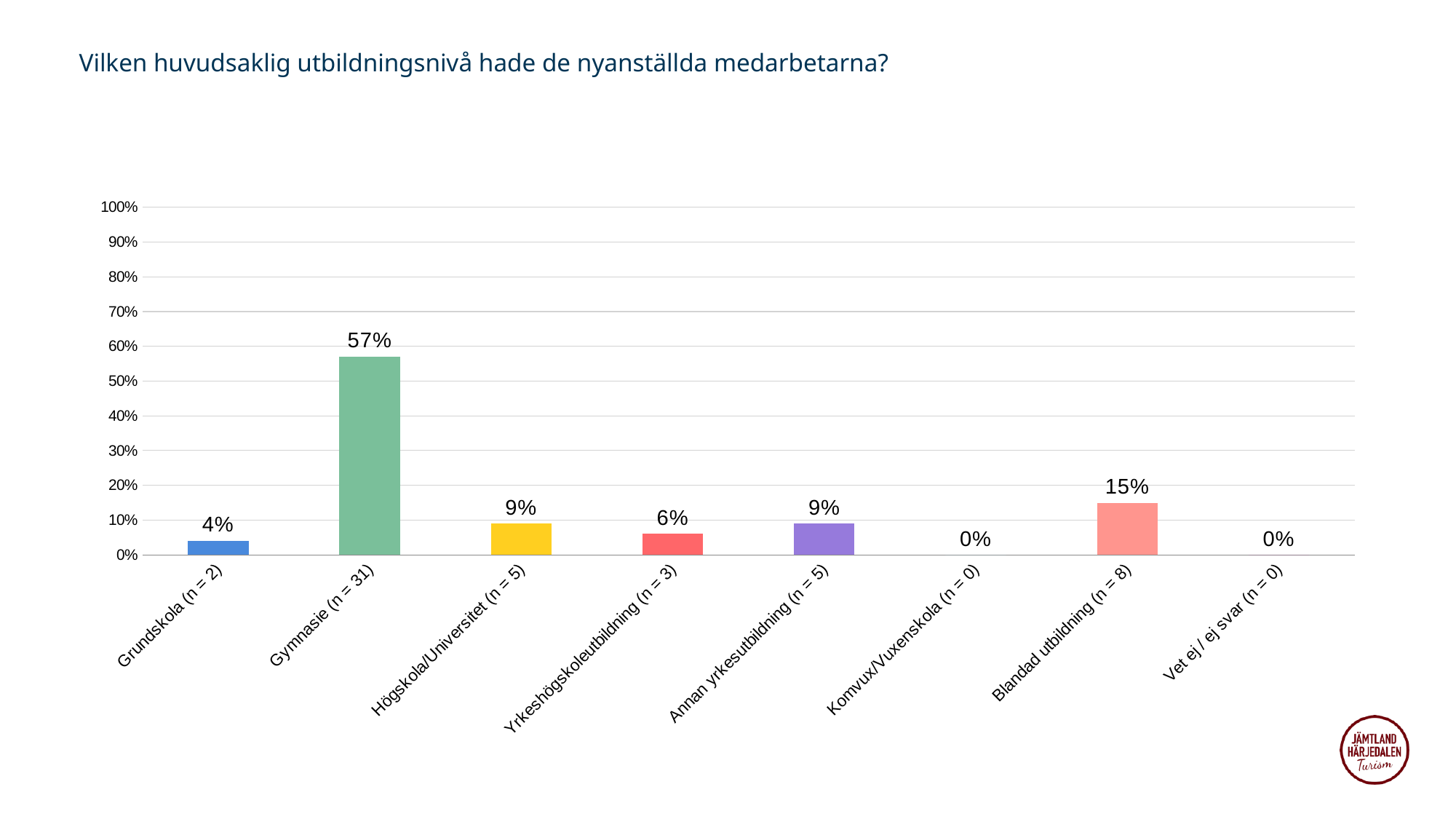
What is the difference between the values for Gymnasie and Blandad utbildning? 42 percentage points Is the value for Gymnasie greater or less than 50%? greater What is the value for Blandad utbildning (n = 8)? 15% What percentage is shown for Gymnasie (n = 31)? 57% How many categories have a value of 0%? 2 How many categories are shown on the x axis? 8 What kind of chart is shown on the slide? Bar chart Which is larger, the value for Grundskola or the value for Högskola/Universitet? Högskola/Universitet What is the title of the slide? Vilken huvudsaklig utbildningsnivå hade de nyanställda medarbetarna? Which education level has the highest percentage? Gymnasie (n = 31) What colour is the bar for Gymnasie (n = 31)? Green What percentage is shown for Yrkeshögskoleutbildning (n = 3)? 6%